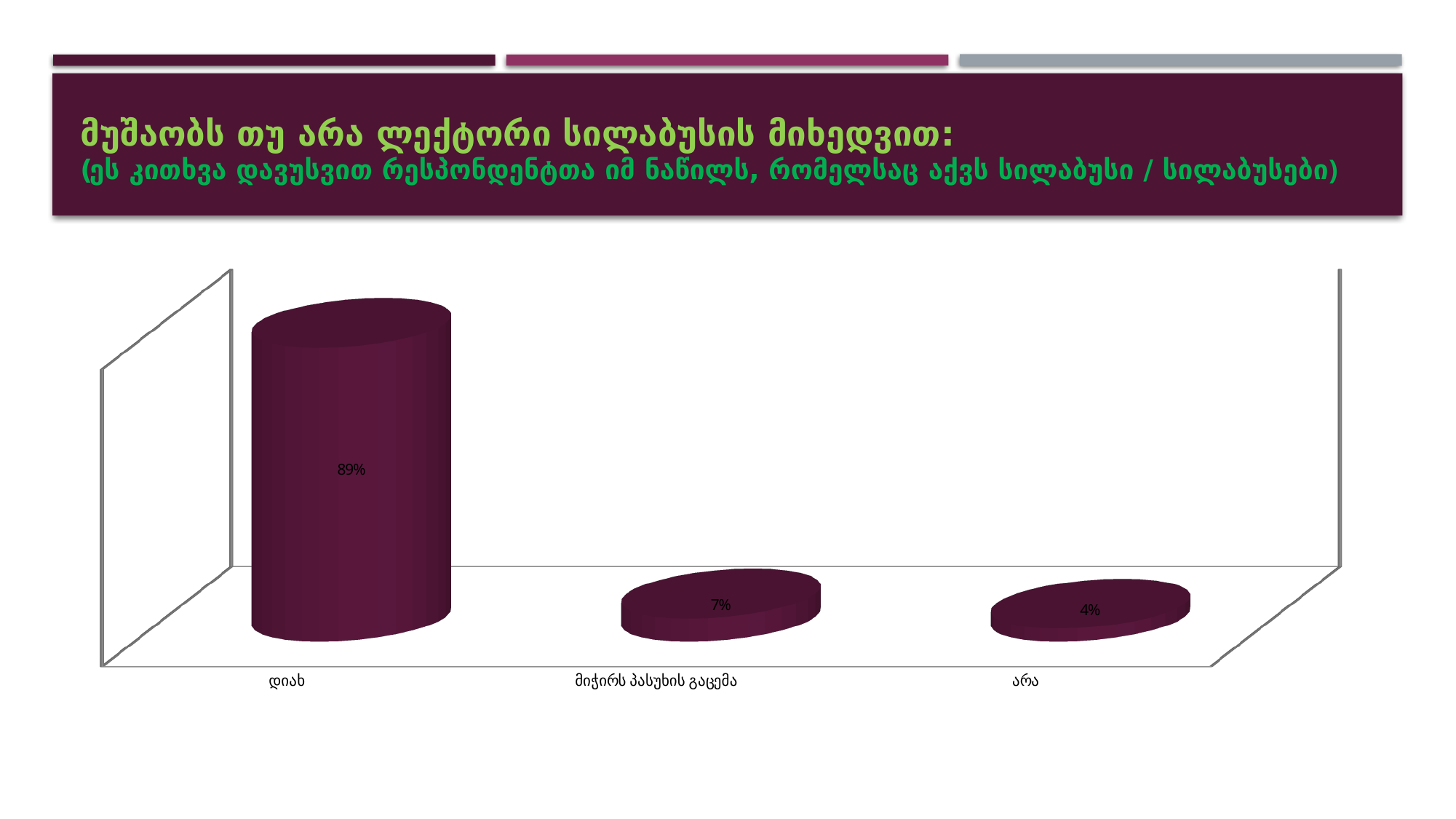
What is the value for the category "მიჭირს პასუხის გაცემა"? 7% What is the difference between the values for "დიახ" and "არა"? 85% How many categories are shown in the chart? 3 Which category has the lowest value? არა What is the total of the three values shown in the chart? 100% Which is larger, the value for "მიჭირს პასუხის გაცემა" or the value for "არა"? მიჭირს პასუხის გაცემა What is the value for the category "დიახ"? 89% Which category has the highest value? დიახ What is the value for the category "არა"? 4% What kind of chart is shown on the slide? Bar chart Do the values rise or fall from left to right across the categories? Fall What is the difference between the values for "მიჭირს პასუხის გაცემა" and "არა"? 3%